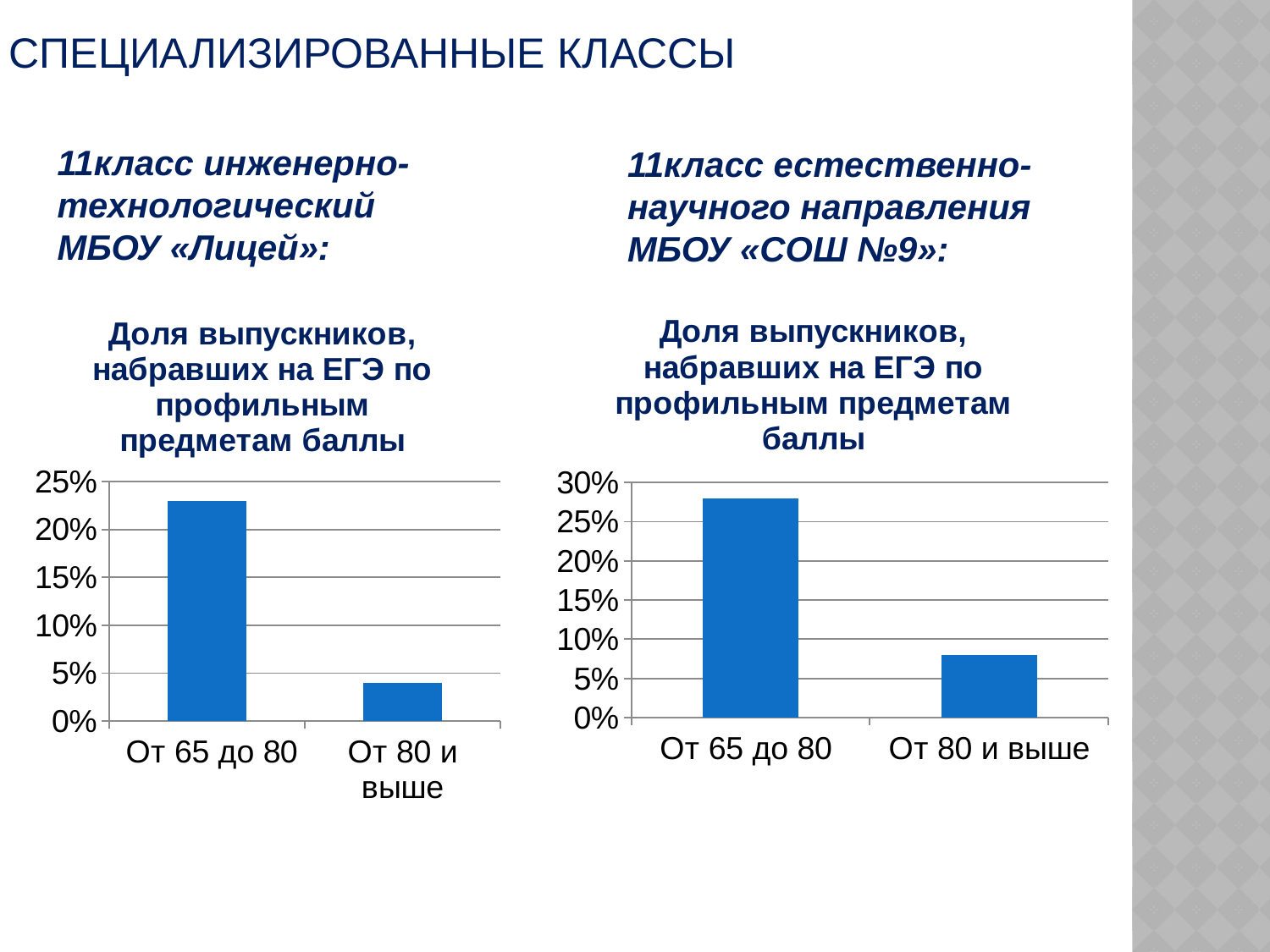
On the left chart (МБОУ «Лицей»), what kind of chart is shown? bar chart What is the title of the left chart (МБОУ «Лицей»)? Доля выпускников, набравших на ЕГЭ по профильным предметам баллы On the left chart (МБОУ «Лицей»), do the values rise or fall from left to right along the x axis? fall On the right chart (МБОУ «СОШ №9»), is the value for От 65 до 80 greater or less than 25%? greater What is the highest value shown on the y axis of the right chart (МБОУ «СОШ №9»)? 30% On the right chart (МБОУ «СОШ №9»), how many categories are shown on the x axis? 2 On the left chart (МБОУ «Лицей»), is the value for От 65 до 80 greater or less than 20%? greater On the right chart (МБОУ «СОШ №9»), is the value for От 80 и выше greater or less than 10%? less On the right chart (МБОУ «СОШ №9»), which is larger: От 65 до 80 or От 80 и выше? От 65 до 80 On the right chart (МБОУ «СОШ №9»), which category has the lowest value? От 80 и выше On the left chart (МБОУ «Лицей»), which category has the highest value? От 65 до 80